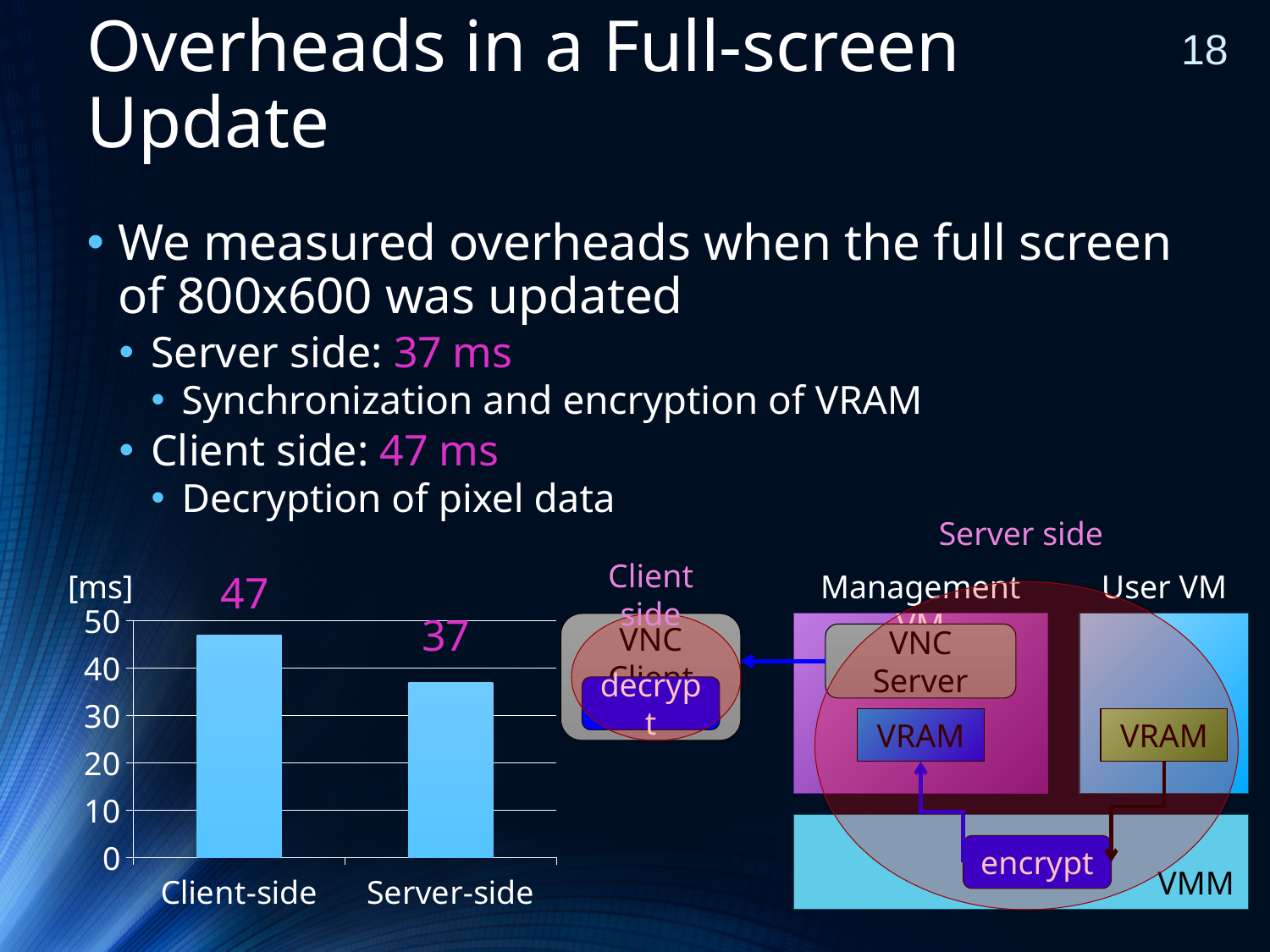
Is the value for Client-side greater or less than 40? greater Which category has the highest value in the bar chart? Client-side Which is larger, the Client-side value or the Server-side value? Client-side Which category has the lowest value in the bar chart? Server-side What kind of chart is shown on the slide? bar chart What unit is shown on the y axis of the bar chart? [ms] What is the value for Server-side in the bar chart? 37 How many categories are shown in the bar chart? 2 What is the maximum value shown on the y axis of the bar chart? 50 What is the difference between the Client-side and Server-side values? 10 Is the value for Server-side greater or less than 40? less What is the value for Client-side in the bar chart? 47